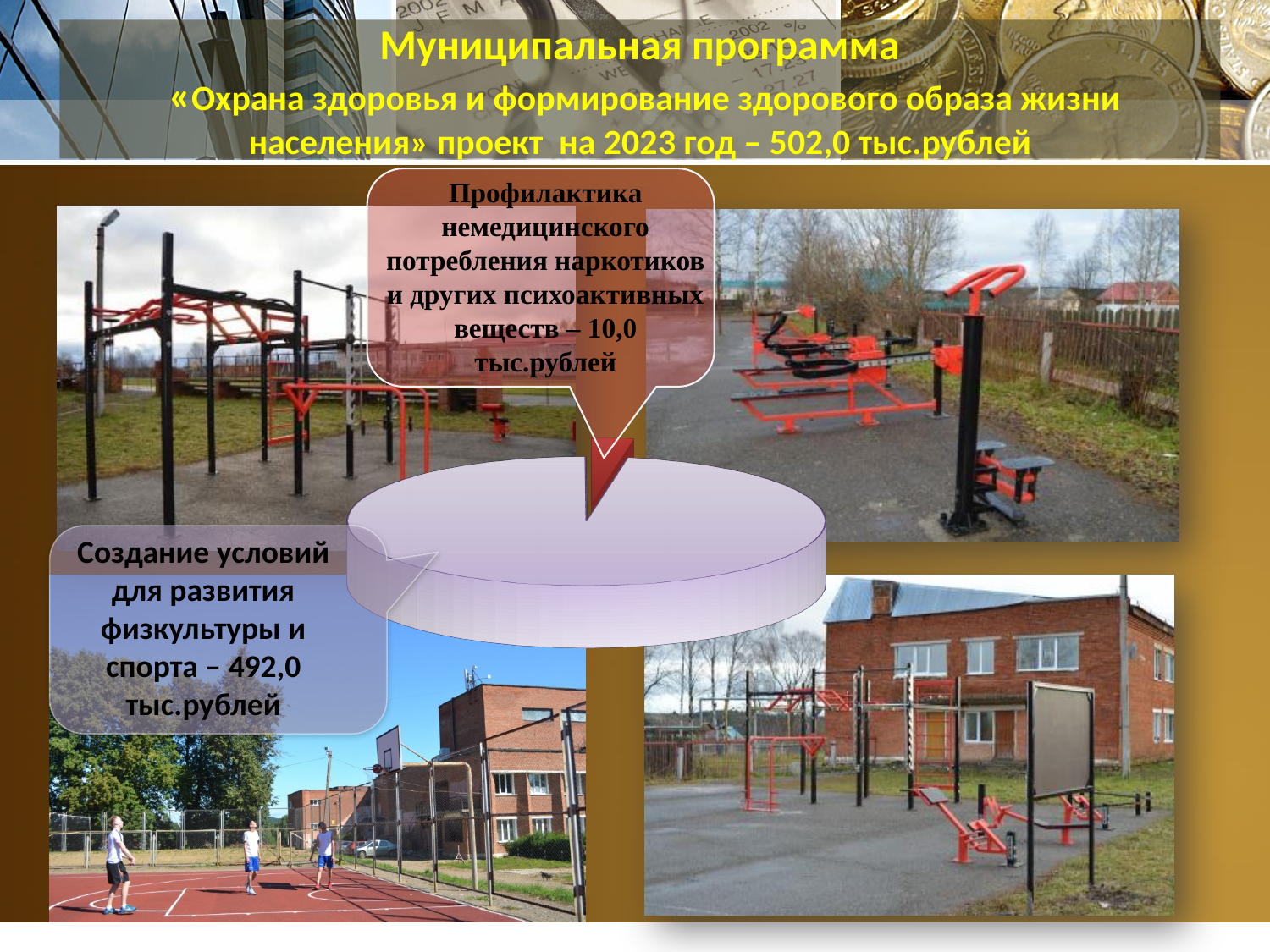
For which year is the programme budget shown on the slide? 2023 What is the value for «Создание условий для развития физкультуры и спорта»? 492,0 тыс.рублей Which slice of the pie chart is the smallest? Профилактика немедицинского потребления наркотиков и других психоактивных веществ Which is larger: the value for «Создание условий для развития физкультуры и спорта» or the value for «Профилактика немедицинского потребления наркотиков»? Создание условий для развития физкультуры и спорта What is the name of the municipal programme in the slide title? «Охрана здоровья и формирование здорового образа жизни населения» What is the difference between the value for «Создание условий для развития физкультуры и спорта» and the value for «Профилактика немедицинского потребления наркотиков»? 482,0 тыс.рублей Is the value for «Создание условий для развития физкультуры и спорта» greater or less than 400 тыс.рублей? greater How many slices does the pie chart have? 2 What is the value for «Профилактика немедицинского потребления наркотиков и других психоактивных веществ»? 10,0 тыс.рублей Which slice of the pie chart is the largest? Создание условий для развития физкультуры и спорта What is the total of the two values shown in the pie chart? 502,0 тыс.рублей What kind of chart is shown on the slide? Pie chart